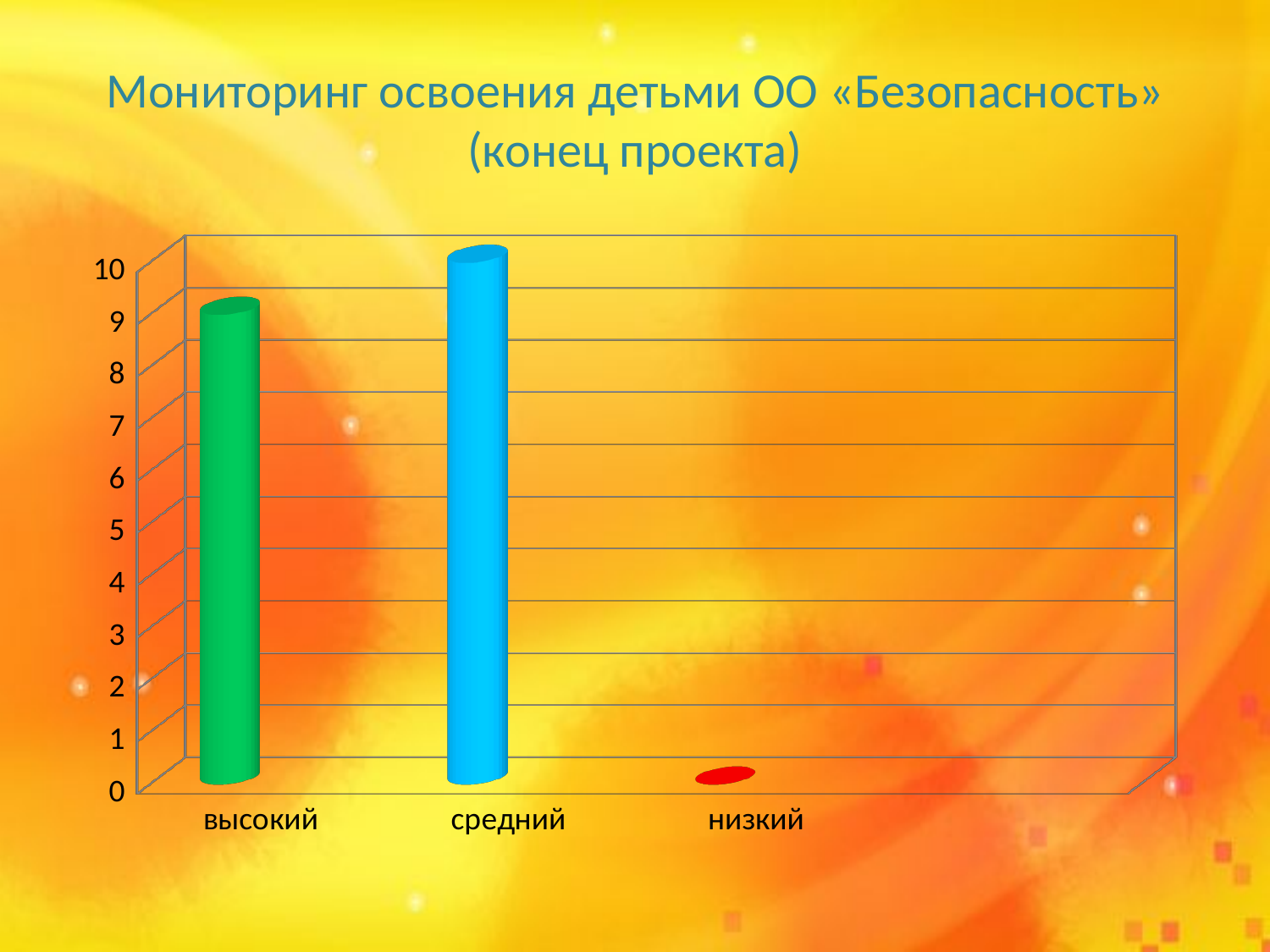
How many categories are shown on the x axis of the chart? 3 Is the value for высокий greater or less than 5? greater Which category has the highest value in the chart? средний Which category has the lowest value in the chart? низкий Is the value for низкий greater or less than 1? less Is the value for средний greater or less than 8? greater What kind of chart is shown on the slide? bar chart What is the value for низкий in the chart? 0 What colour is the bar for средний? blue What is the title of the chart on the slide? Мониторинг освоения детьми ОО «Безопасность» (конец проекта) Which is larger, the value for высокий or the value for средний? средний Which is larger, the value for высокий or the value for низкий? высокий